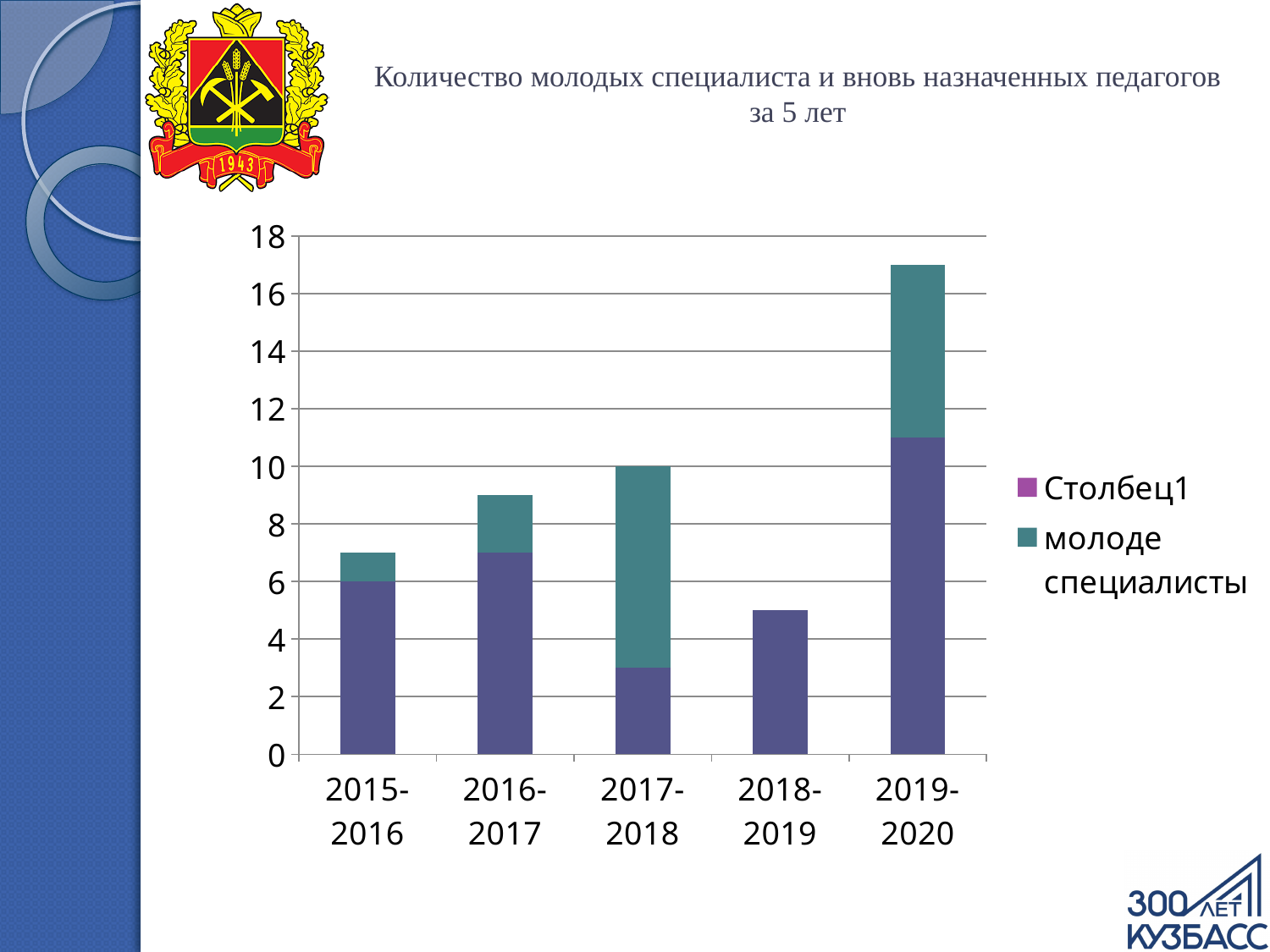
How many series does the legend list? 2 What is the total height of the stacked bar for 2017-2018? 10 Which stacked bar is taller, 2016-2017 or 2015-2016? 2016-2017 Is the total of the stacked bar for 2019-2020 greater or less than 16? greater Is the total of the stacked bar for 2018-2019 greater or less than 6? less Which year has the tallest stacked bar? 2019-2020 What are the two entries listed in the legend? Столбец1 and молоде специалисты Which year has the shortest stacked bar? 2018-2019 How many year categories are shown on the x axis? 5 What kind of chart is shown on the slide? bar chart